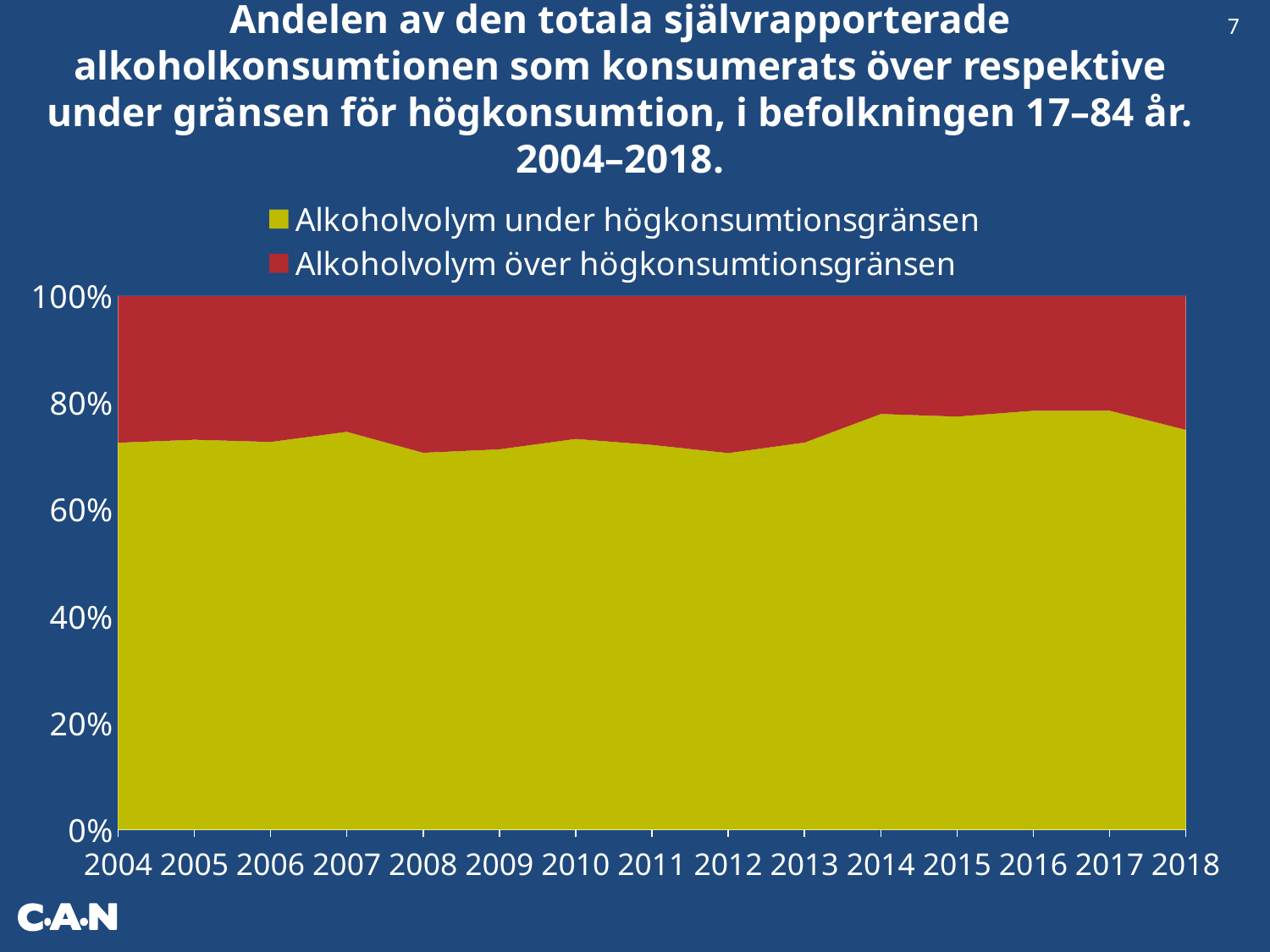
How many series does the legend list? 2 Which colour represents Alkoholvolym över högkonsumtionsgränsen in the legend? Red How many years are shown on the x axis? 15 Is the value for Alkoholvolym under högkonsumtionsgränsen in 2008 greater or less than 80%? less Which years does the x axis span? 2004 to 2018 What kind of chart is shown on the slide? Area chart Which series occupies the larger share in 2010, Alkoholvolym under högkonsumtionsgränsen or Alkoholvolym över högkonsumtionsgränsen? Alkoholvolym under högkonsumtionsgränsen Does the share for Alkoholvolym under högkonsumtionsgränsen rise or fall from 2012 to 2014? rise What is the top value shown on the y axis? 100% Is the value for Alkoholvolym under högkonsumtionsgränsen in 2004 greater or less than 60%? greater Is the value for Alkoholvolym under högkonsumtionsgränsen in 2014 greater or less than 60%? greater